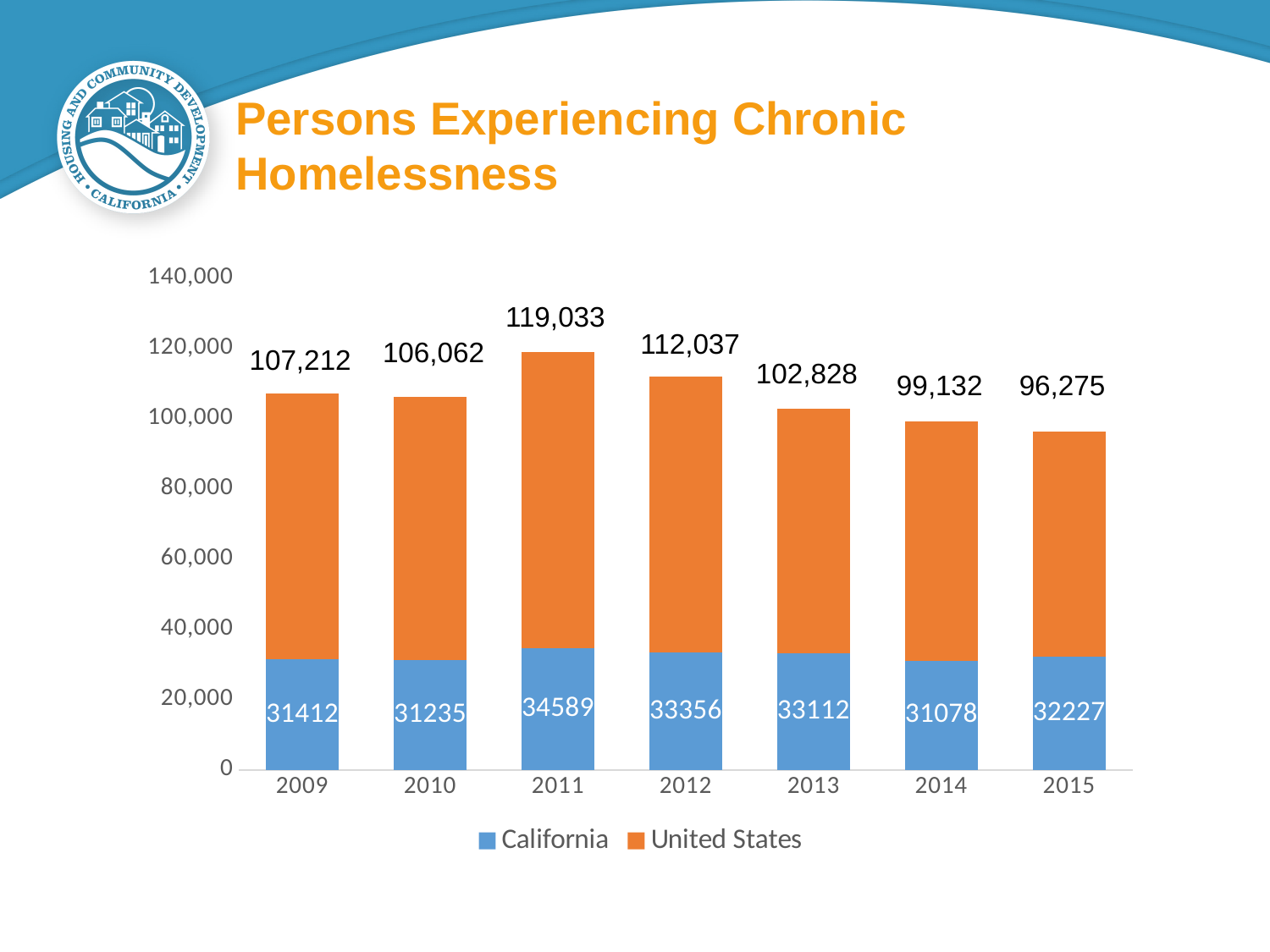
Which year has the lowest California value? 2014 Do the totals labeled above the bars rise or fall from 2012 to 2015? Fall What kind of chart is shown on the slide? Stacked bar chart How many years are shown on the x axis? 7 What total is labeled above the 2013 bar? 102,828 What is the California value for 2011? 34589 Which year has the highest total labeled above its bar? 2011 How many series does the legend list? 2 Which year has the lowest total labeled above its bar? 2015 Is the California value larger in 2012 or 2013? 2012 What is the difference between the totals labeled for 2011 and 2015? 22,758 What is the California value for 2014? 31078